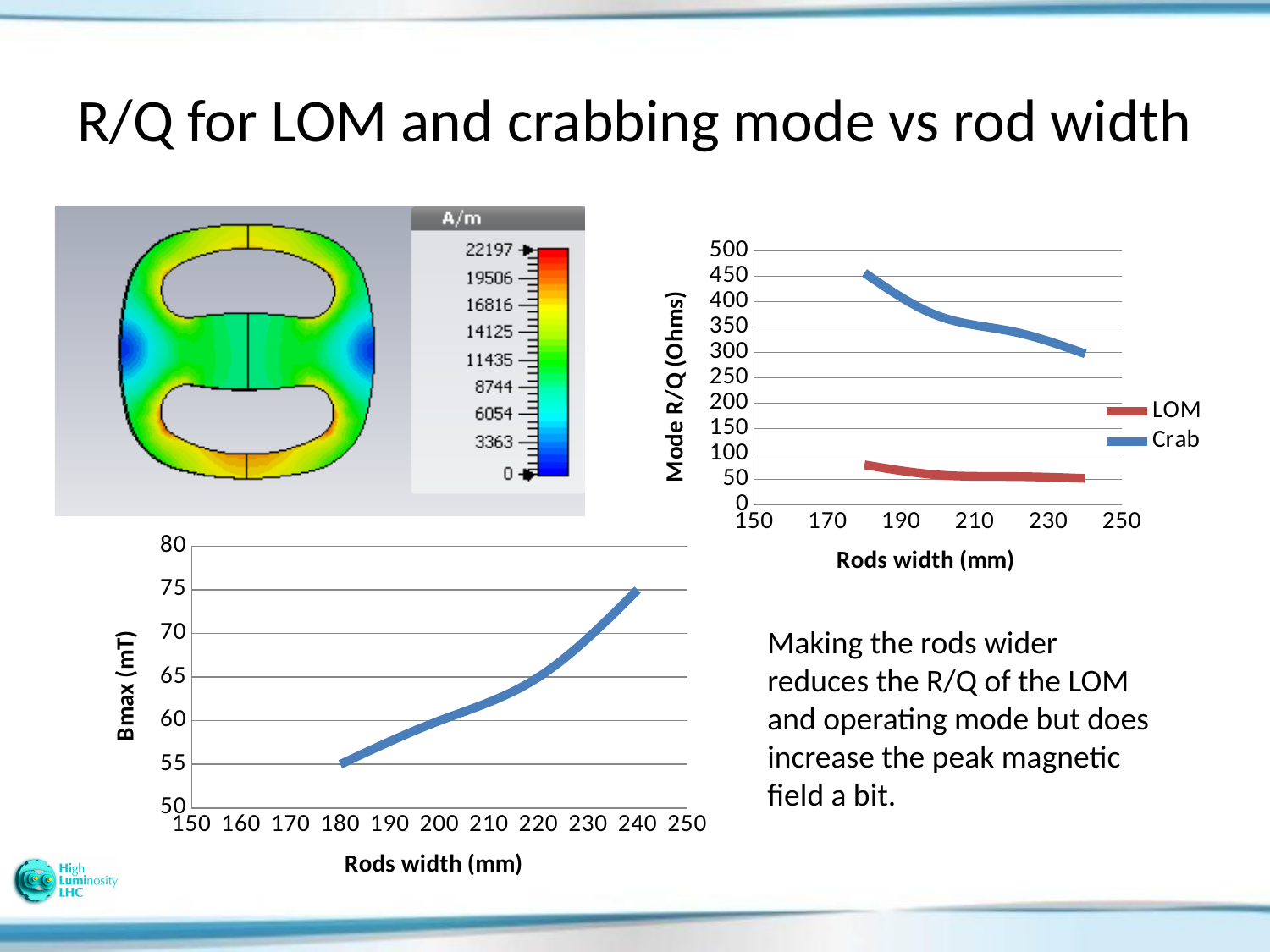
In the chart with the LOM and Crab legend, what kind of chart is it? line chart In the Bmax (mT) chart, does the value rise or fall as rods width increases? rise In the chart with the LOM and Crab legend, is the Crab value at a rods width of 240 mm greater or less than 350? less In the chart with the LOM and Crab legend, does the Crab series rise or fall as rods width increases? fall In the Bmax (mT) chart, is the value at a rods width of 240 mm greater or less than 70? greater In the chart with the LOM and Crab legend, is the Crab value at a rods width of 180 mm greater or less than 400? greater In the chart with the LOM and Crab legend, does the LOM series rise or fall as rods width increases? fall In the chart with the LOM and Crab legend, what is the label of the vertical axis? Mode R/Q (Ohms) In the chart with the LOM and Crab legend, how many series does the legend list? 2 In the chart with the LOM and Crab legend, which series has the higher R/Q at a rods width of 180 mm? Crab